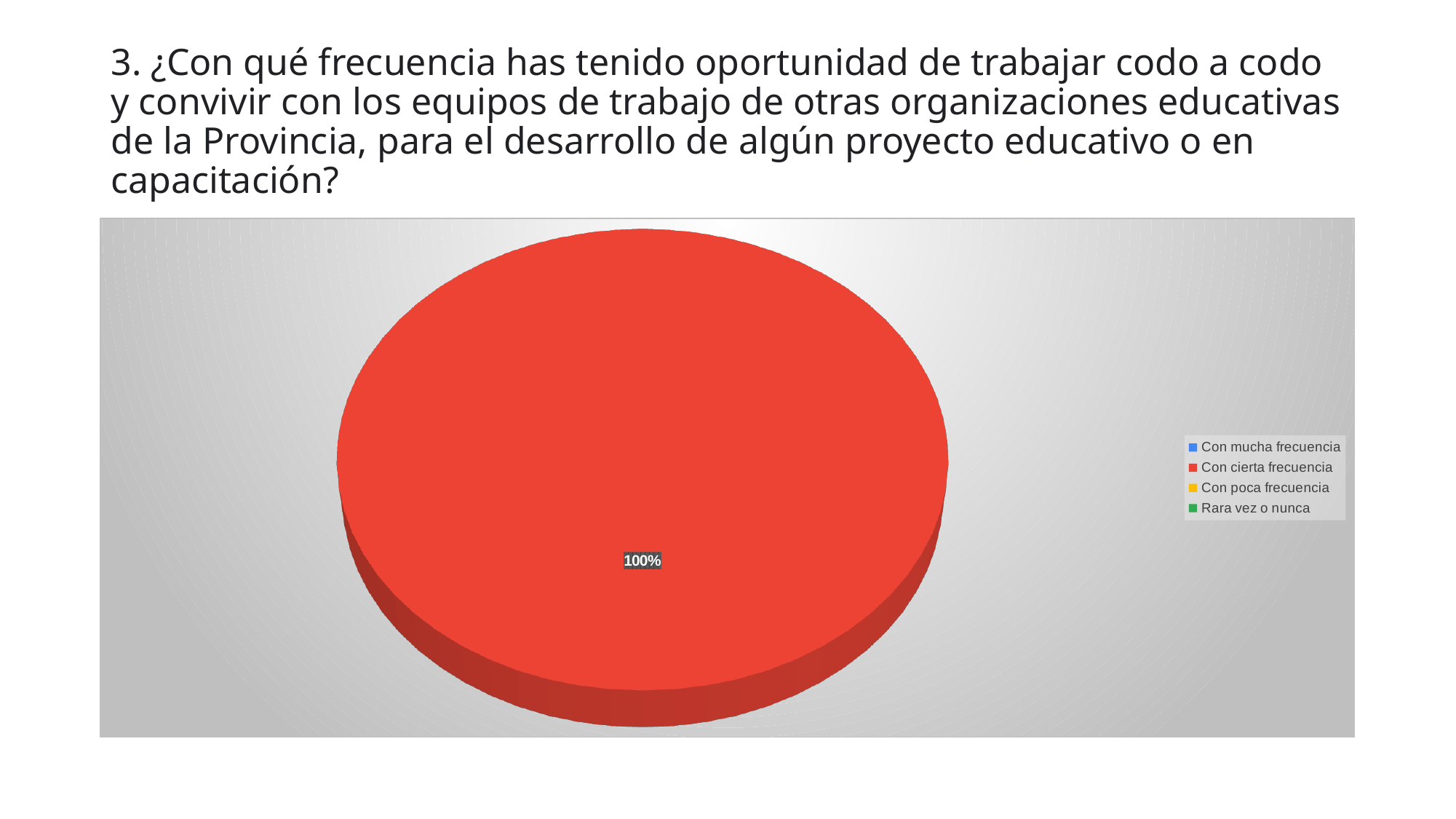
How many slices are visible in the pie? 1 Is the share for "Con cierta frecuencia" greater or less than 50%? greater What kind of chart is shown on the slide? pie chart How many entries does the legend list? 4 Which legend entry is shown in blue? Con mucha frecuencia What is the only data label printed on the pie? 100% Which category makes up the entire pie? Con cierta frecuencia What share of the pie does "Con cierta frecuencia" have? 100% What colour is the slice for "Con cierta frecuencia"? red